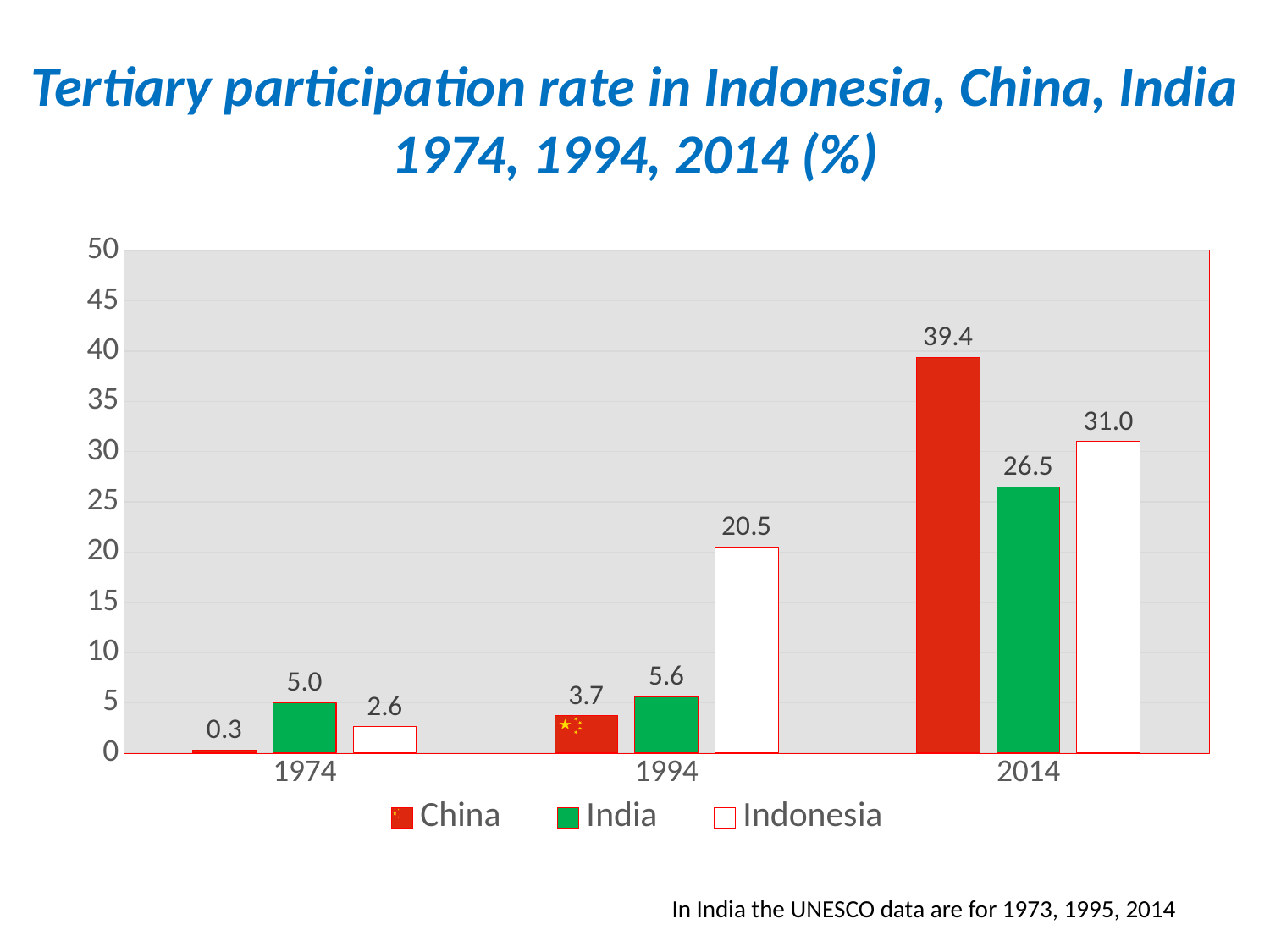
In 1994, which is larger: the rate for India or the rate for China? India Does China's tertiary participation rate rise or fall from 1974 to 2014? Rise What kind of chart is shown on the slide? Bar chart Is the value for Indonesia in 2014 greater or less than 30? greater Which country has the highest tertiary participation rate in 2014? China What is the tertiary participation rate for Indonesia in 1994? 20.5 How many years are shown on the x axis? 3 What is the tertiary participation rate for China in 2014? 39.4 How many series does the legend list? 3 Which country has the lowest tertiary participation rate in 1974? China What is the difference between Indonesia's and India's tertiary participation rates in 2014? 4.5 What is the tertiary participation rate for India in 1974? 5.0